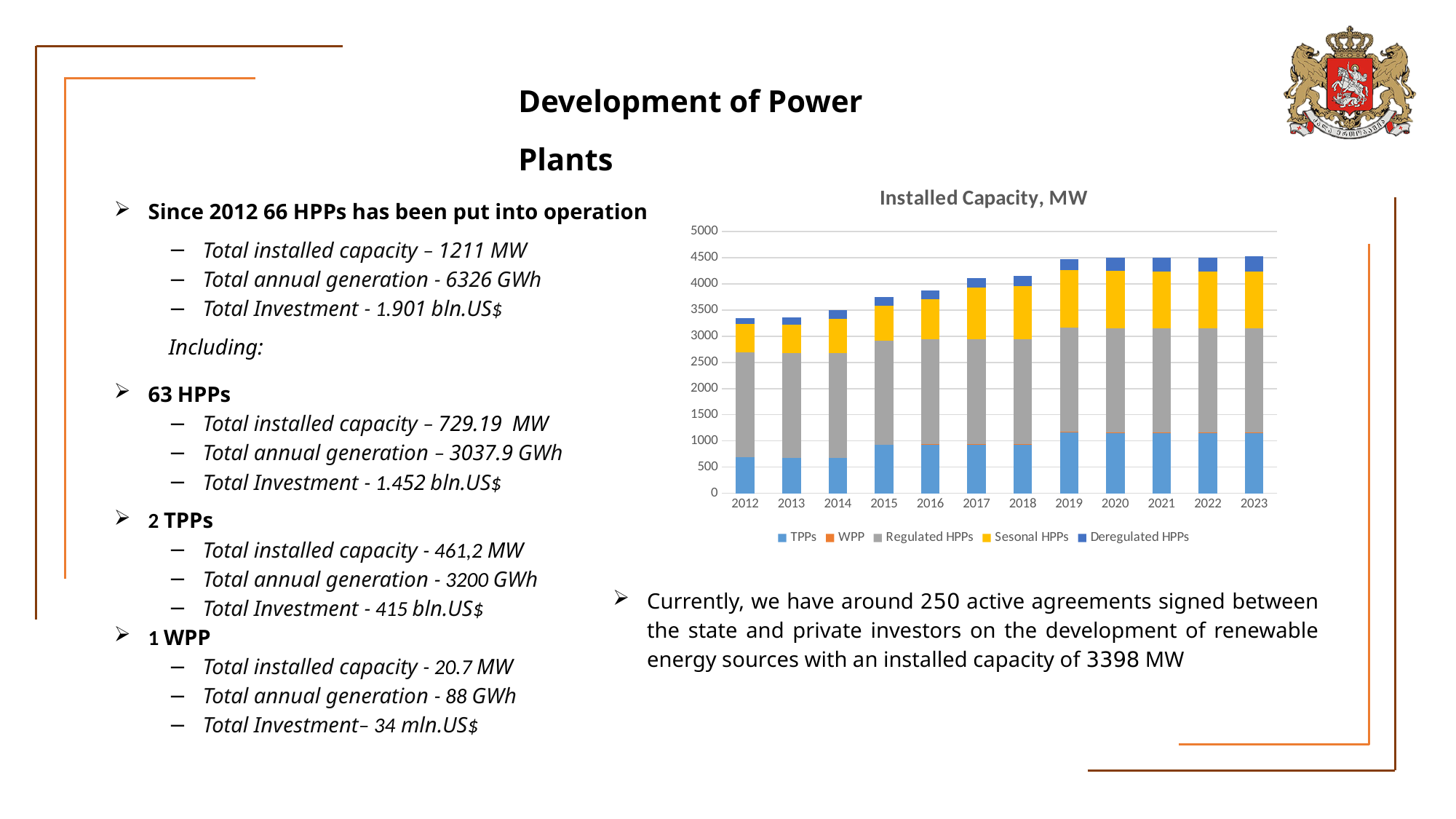
Is the TPPs value for 2012 greater or less than 500? greater How many series does the chart legend list? 5 Is the total installed capacity for 2012 greater or less than 3000? greater What is the title of the chart? Installed Capacity, MW What type of chart is shown on the slide? Stacked bar chart Does the total installed capacity rise or fall from 2012 to 2023? rise Is the total installed capacity for 2019 greater or less than 5000? less Which series is shown in yellow in the chart? Sesonal HPPs Which year has the larger total installed capacity, 2012 or 2023? 2023 How many years are shown on the x axis of the chart? 12